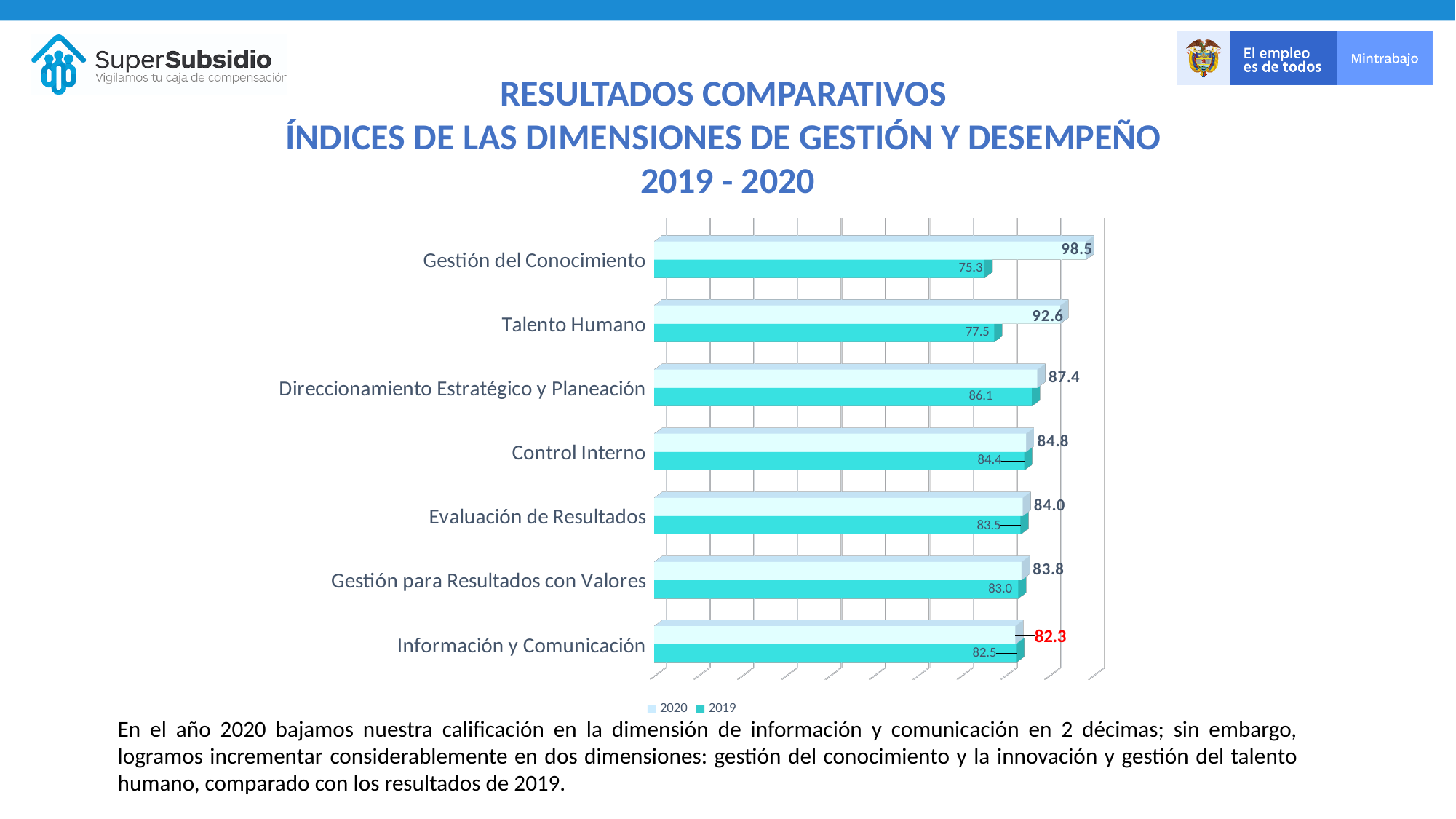
Which category has the lowest 2019 value? Gestión del Conocimiento What kind of chart is shown on the slide? Bar chart Which category has the highest 2020 value? Gestión del Conocimiento What is the 2020 value for Gestión del Conocimiento? 98.5 What is the difference between the 2020 and 2019 values for Talento Humano? 15.1 What is the 2019 value for Control Interno? 84.4 What is the 2020 value for Información y Comunicación? 82.3 For Información y Comunicación, which year has the larger value, 2019 or 2020? 2019 What is the difference between the 2020 and 2019 values for Gestión del Conocimiento? 23.2 How many categories are shown in the chart? 7 How many series does the legend list? 2 What is the 2019 value for Talento Humano? 77.5